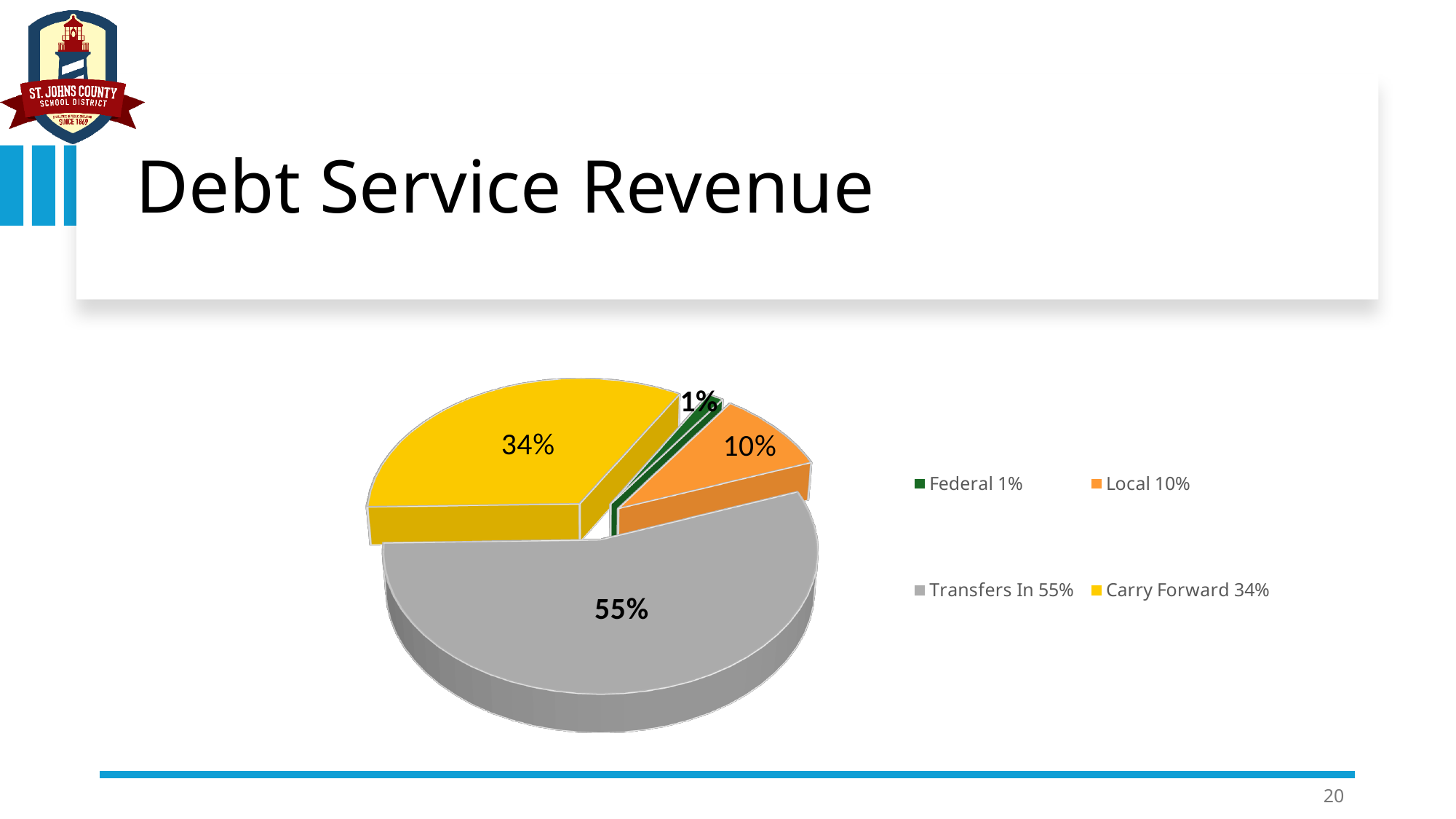
What is the combined share of Local and Federal revenue? 11% What kind of chart is shown on the slide? Pie chart What colour is the Carry Forward slice? Yellow What is the difference in percentage points between Transfers In and Carry Forward? 21 Which revenue source has the smallest share of the pie? Federal Which is larger, the Local share or the Carry Forward share? Carry Forward How many slices does the pie chart have? 4 What share of Debt Service Revenue comes from Transfers In? 55% What share of Debt Service Revenue comes from Carry Forward? 34% Which revenue source has the largest share of the pie? Transfers In What share of Debt Service Revenue comes from Local sources? 10% What share of Debt Service Revenue comes from Federal sources? 1%